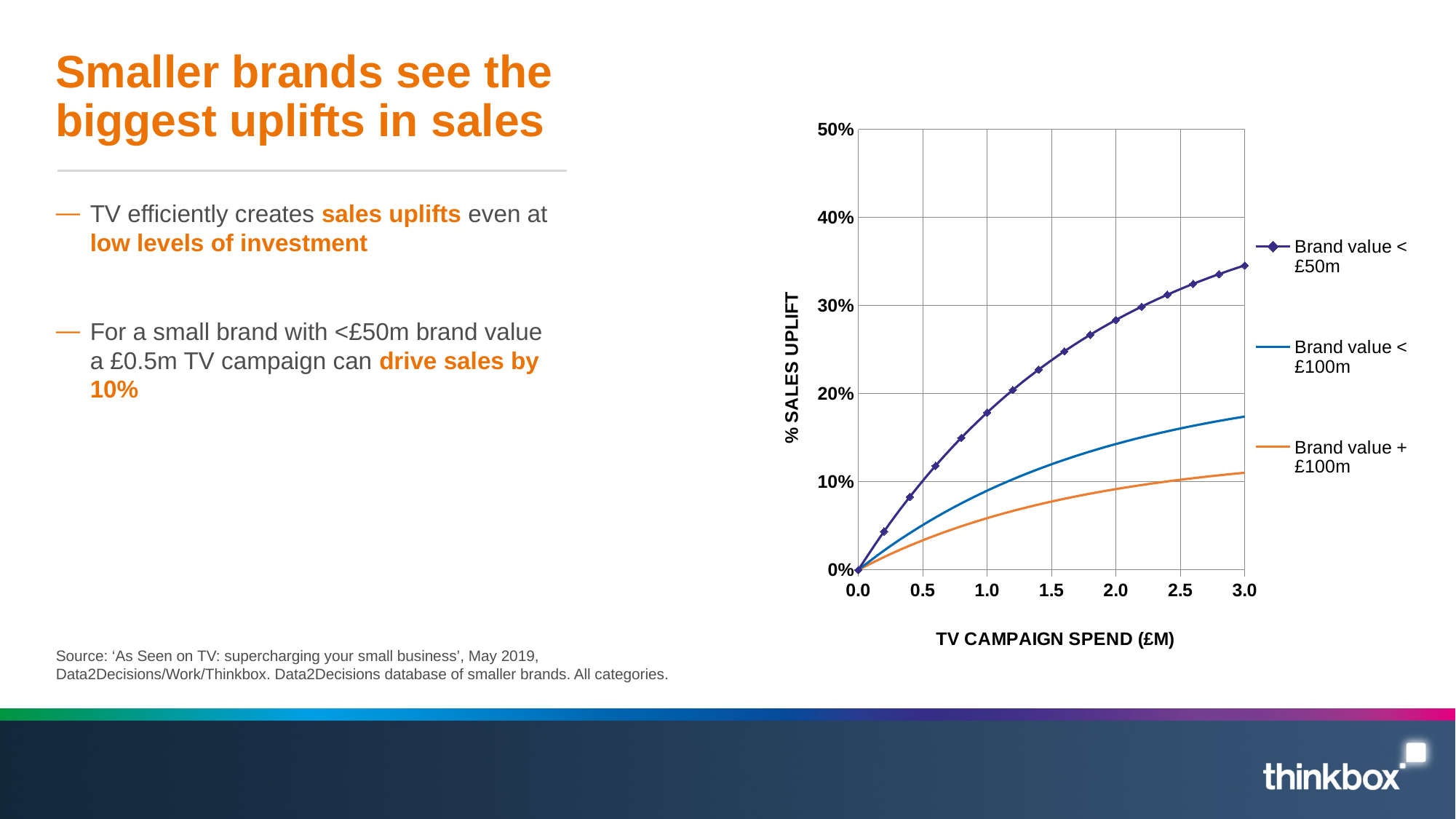
Is the % sales uplift for Brand value + £100m at a spend of 2.0 (£m) greater or less than 10%? less Is the % sales uplift for Brand value < £50m at a spend of 3.0 (£m) greater or less than 30%? greater Which series has the lowest % sales uplift at a TV campaign spend of 3.0 (£m)? Brand value + £100m What is the title of the chart's x axis? TV CAMPAIGN SPEND (£M) Which series has the highest % sales uplift at a TV campaign spend of 3.0 (£m)? Brand value < £50m At a TV campaign spend of 2.0 (£m), which series has the larger % sales uplift: Brand value < £100m or Brand value + £100m? Brand value < £100m What is the % sales uplift for all three series at a TV campaign spend of 0.0 (£m)? 0% Is the % sales uplift for Brand value < £50m at a spend of 1.0 (£m) greater or less than 20%? less Does the % sales uplift for Brand value < £50m rise or fall as TV campaign spend increases? Rise How many series does the chart's legend list? 3 What kind of chart is shown on the slide? Line chart